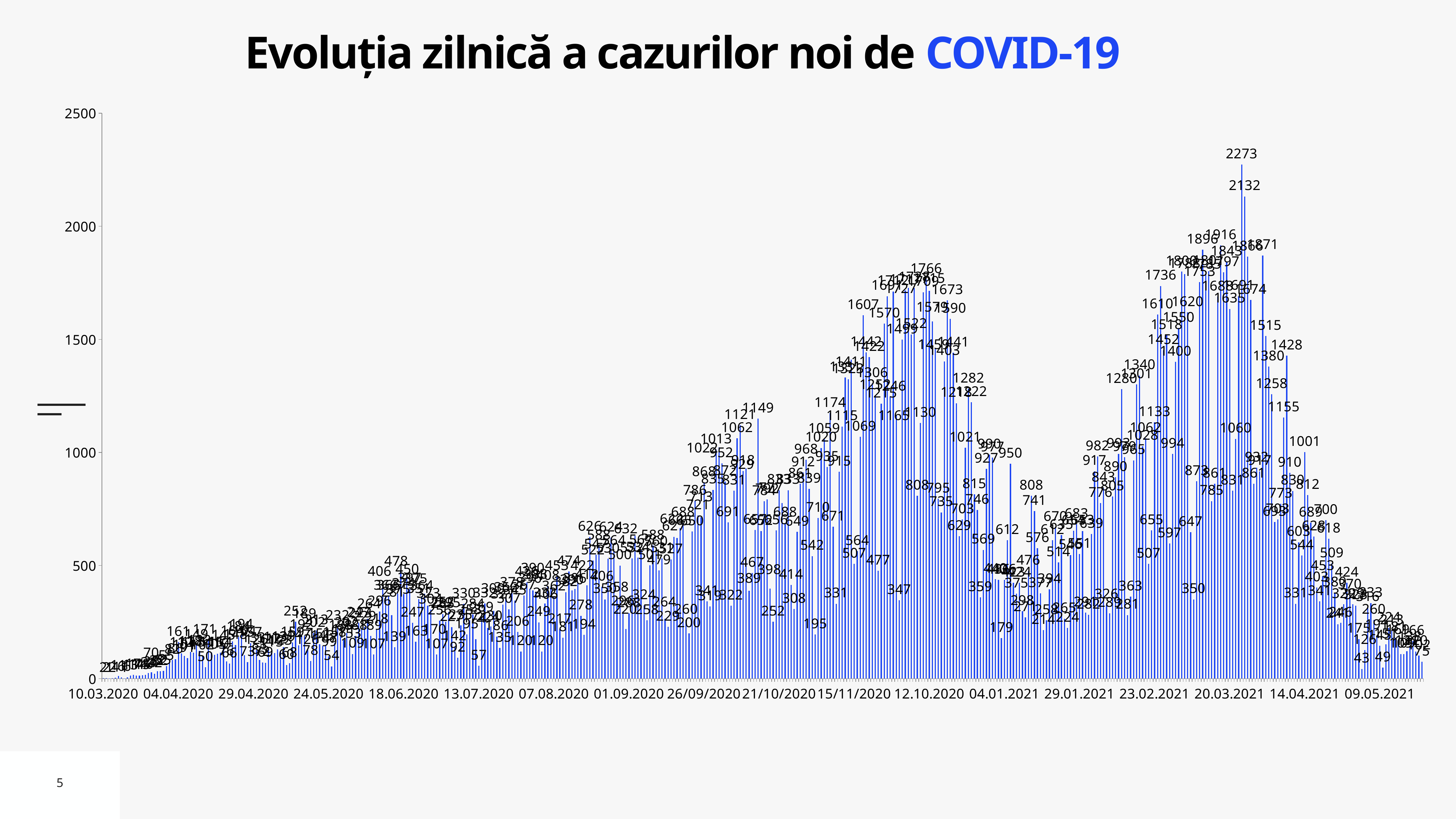
What is the highest daily value shown on the chart? 2273 Do the values rise or fall between 10.03.2020 and 04.04.2020? rise What kind of chart is shown on the slide? bar chart What is the highest value shown on the vertical axis? 2500 What is the title of the chart? Evoluția zilnică a cazurilor noi de COVID-19 Which is larger, the bar labelled 2273 or the bar labelled 2132? 2273 Is the highest bar on the chart greater or less than 2000? greater What is the difference between the two highest labelled values, 2273 and 2132? 141 Do the values rise or fall between 14.04.2021 and 09.05.2021? fall Is the value for 09.05.2021 greater or less than 500? less Is the value for 10.03.2020 greater or less than 500? less What is the second highest data label shown on the chart? 2132